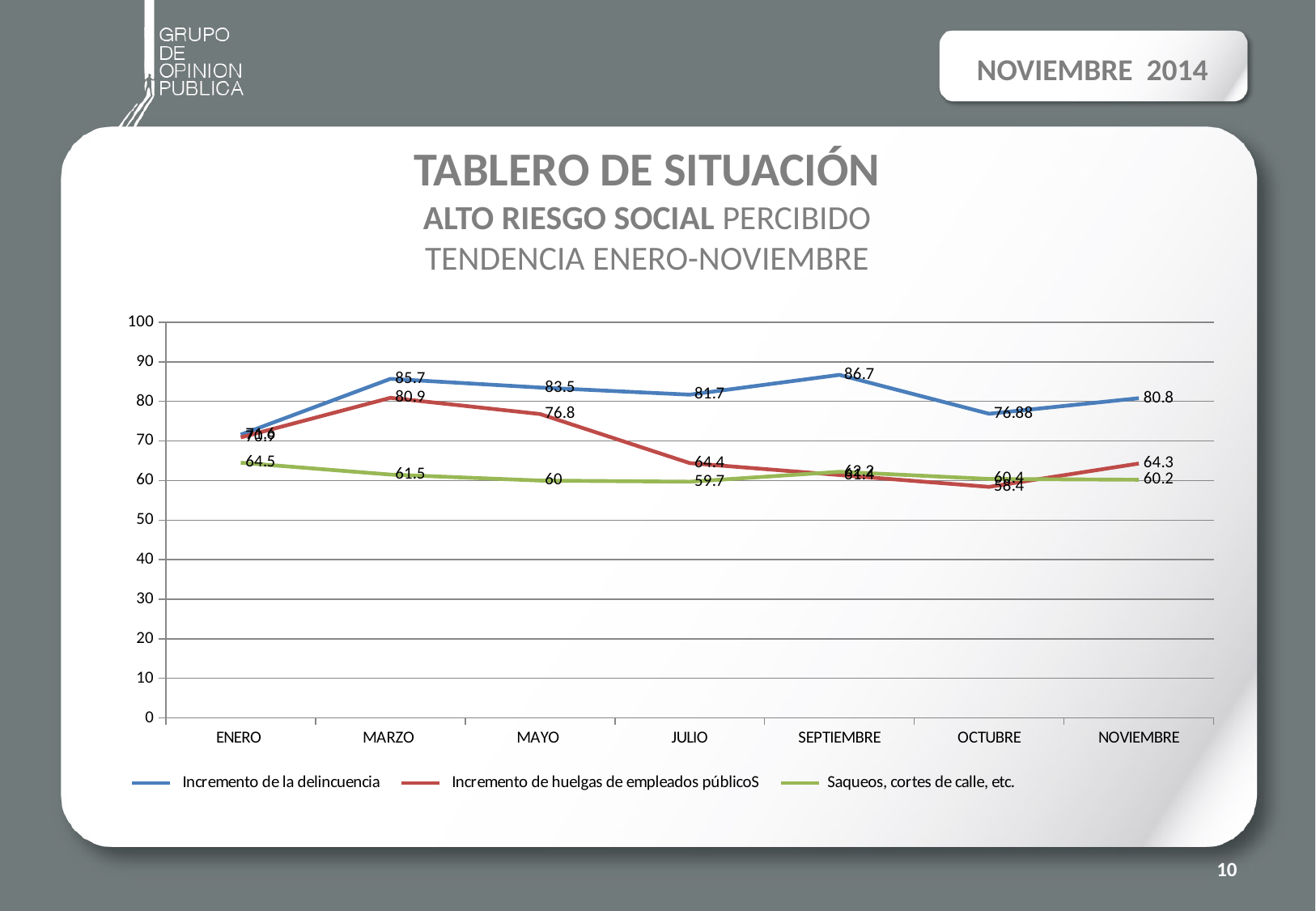
What is the value for Incremento de la delincuencia in SEPTIEMBRE? 86.7 What is the difference between Incremento de la delincuencia and Incremento de huelgas de empleados públicoS in NOVIEMBRE? 16.5 In which month does Incremento de la delincuencia reach its highest value? SEPTIEMBRE What is the value for Saqueos, cortes de calle, etc. in JULIO? 59.7 Which is larger in MAYO: Incremento de huelgas de empleados públicoS or Saqueos, cortes de calle, etc.? Incremento de huelgas de empleados públicoS How many series does the legend list? 3 What is the value for Incremento de la delincuencia in OCTUBRE? 76.88 What kind of chart is shown on the slide? line chart Does Incremento de huelgas de empleados públicoS rise or fall from MARZO to OCTUBRE? fall In which month does Incremento de huelgas de empleados públicoS reach its lowest value? OCTUBRE How many months are shown along the x axis? 7 What is the value for Incremento de huelgas de empleados públicoS in MARZO? 80.9